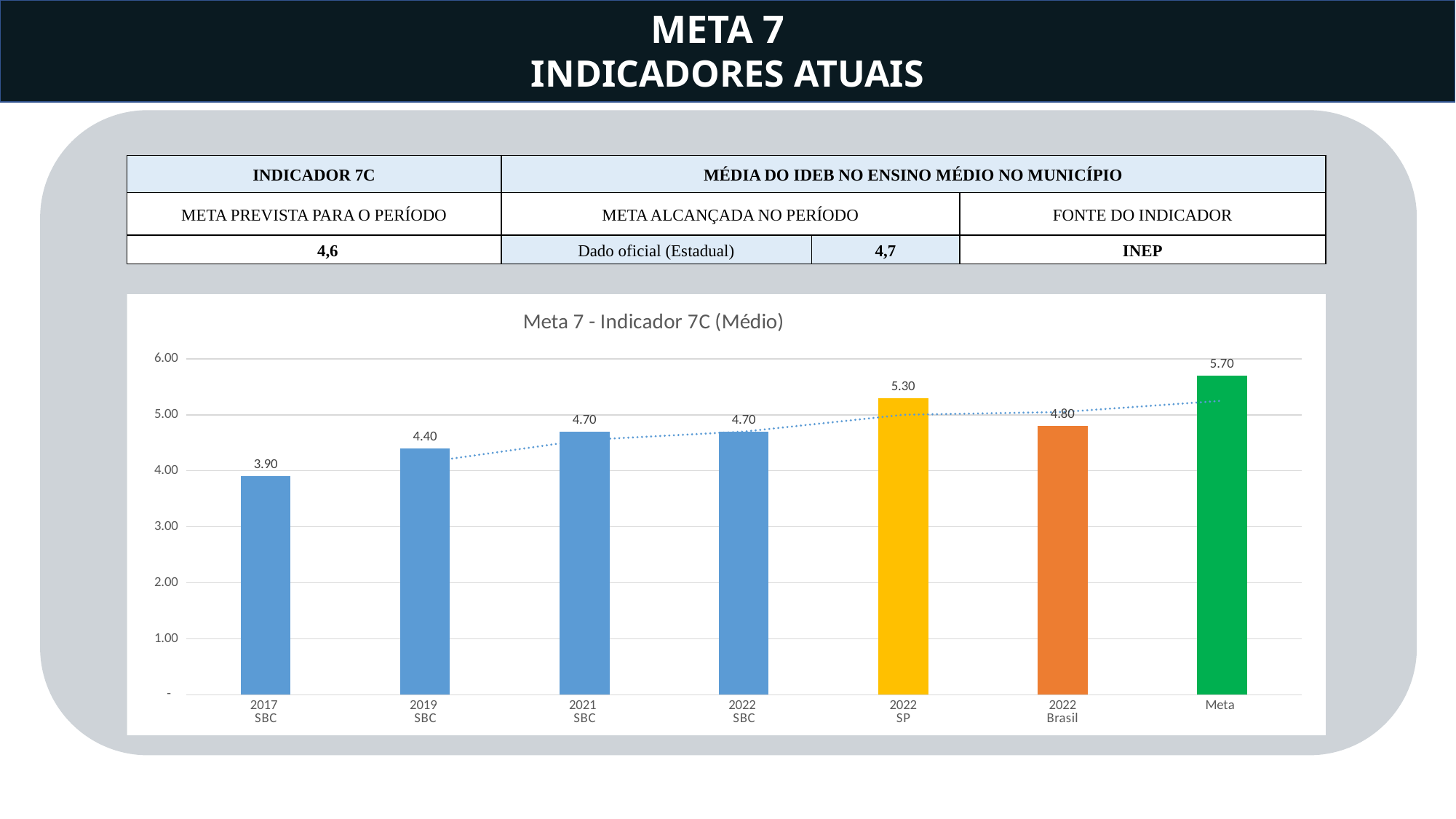
Which is larger, the value for 2022 SP or the value for 2022 Brasil? 2022 SP What kind of chart is shown on the slide? Bar chart What is the difference between the Meta value and the 2022 SBC value? 1.00 What is the value for the Meta bar? 5.70 What is the value for 2017 SBC? 3.90 How many bars are shown in the chart? 7 What is the value for 2022 Brasil? 4.80 Do the SBC values rise or fall from 2017 to 2021? Rise What is the title of the chart? Meta 7 - Indicador 7C (Médio) Which category has the highest value? Meta What is the value for 2022 SP? 5.30 Which category has the lowest value? 2017 SBC